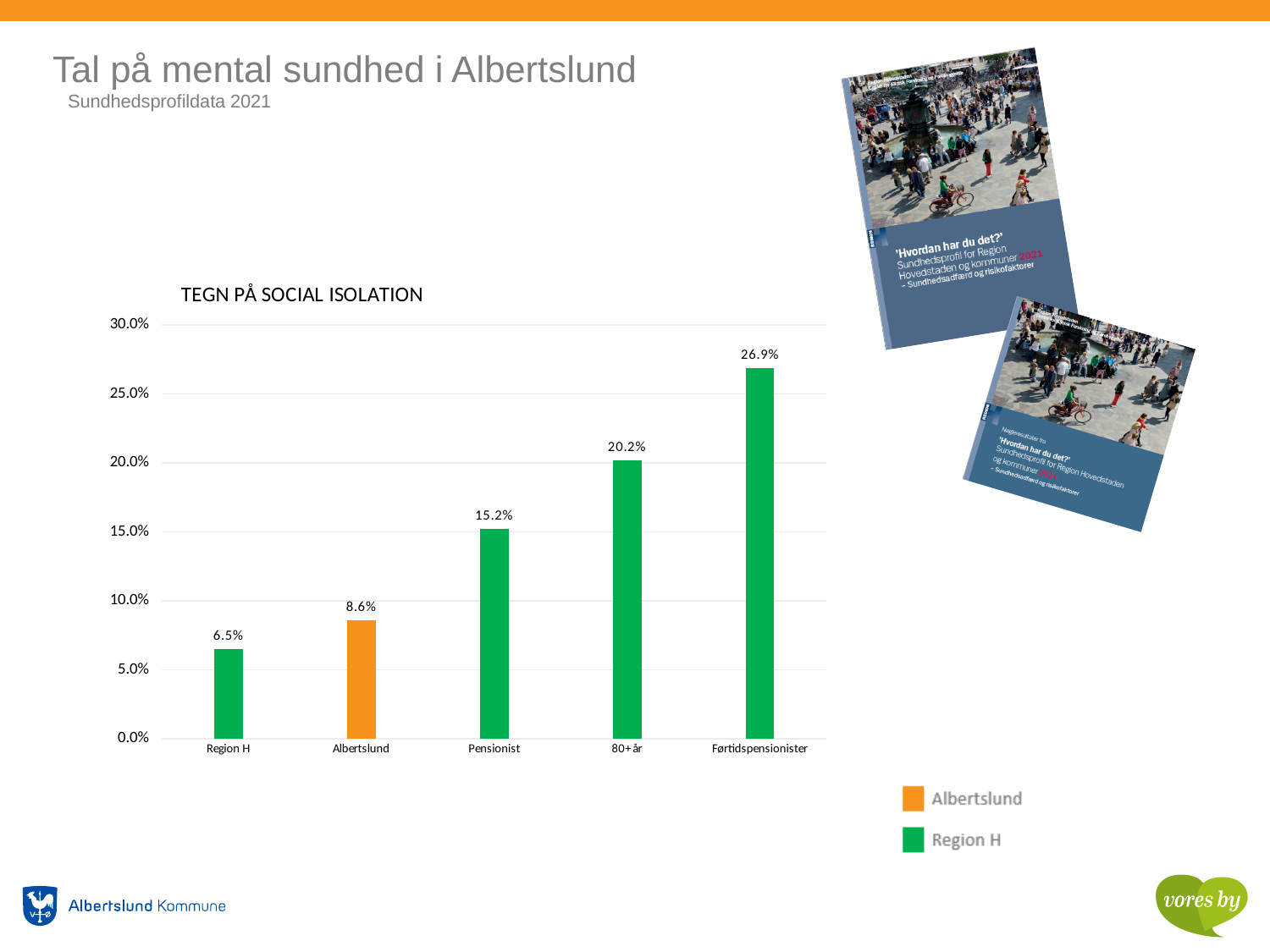
What is the value for Albertslund in the chart? 8.6% What kind of chart is shown on the slide? Bar chart What is the value for Region H in the chart? 6.5% What is the title of the chart? TEGN PÅ SOCIAL ISOLATION What is the value for Førtidspensionister in the chart? 26.9% Which category has the lowest value in the chart? Region H What is the value for 80+ år in the chart? 20.2% What is the difference between the values for Albertslund and Region H? 2.1% How many categories are shown on the x axis of the chart? 5 Which category has the highest value in the chart? Førtidspensionister What is the value for Pensionist in the chart? 15.2% Which is larger, the value for Pensionist or the value for 80+ år? 80+ år